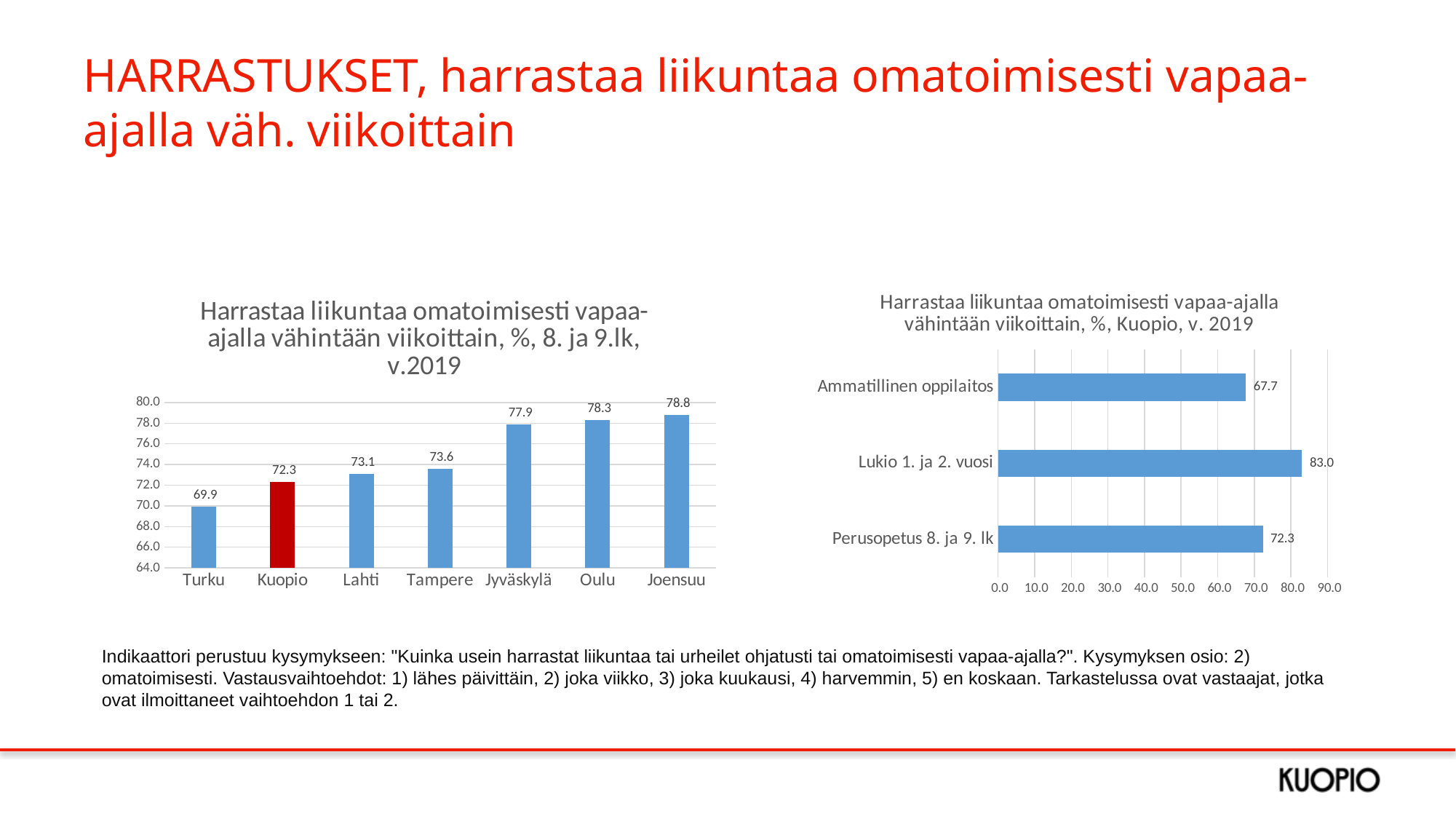
In the left chart (8. ja 9.lk, v.2019), which bar is coloured red? Kuopio In the left chart (8. ja 9.lk, v.2019), which city has the highest value? Joensuu In the left chart (8. ja 9.lk, v.2019), what is the difference between Joensuu and Turku? 8.9 In the right chart (Kuopio, v. 2019), how many categories are shown? 3 In the left chart (8. ja 9.lk, v.2019), which city has the lowest value? Turku What kind of chart is the right chart (Kuopio, v. 2019)? Bar chart In the left chart (8. ja 9.lk, v.2019), how many cities are shown? 7 In the right chart (Kuopio, v. 2019), which category has the lowest value? Ammatillinen oppilaitos In the right chart (Kuopio, v. 2019), what is the difference between Lukio 1. ja 2. vuosi and Ammatillinen oppilaitos? 15.3 In the left chart (8. ja 9.lk, v.2019), which is larger, the value for Lahti or the value for Tampere? Tampere In the right chart (Kuopio, v. 2019), what is the value for Lukio 1. ja 2. vuosi? 83.0 In the left chart (8. ja 9.lk, v.2019), what is the value for Kuopio? 72.3